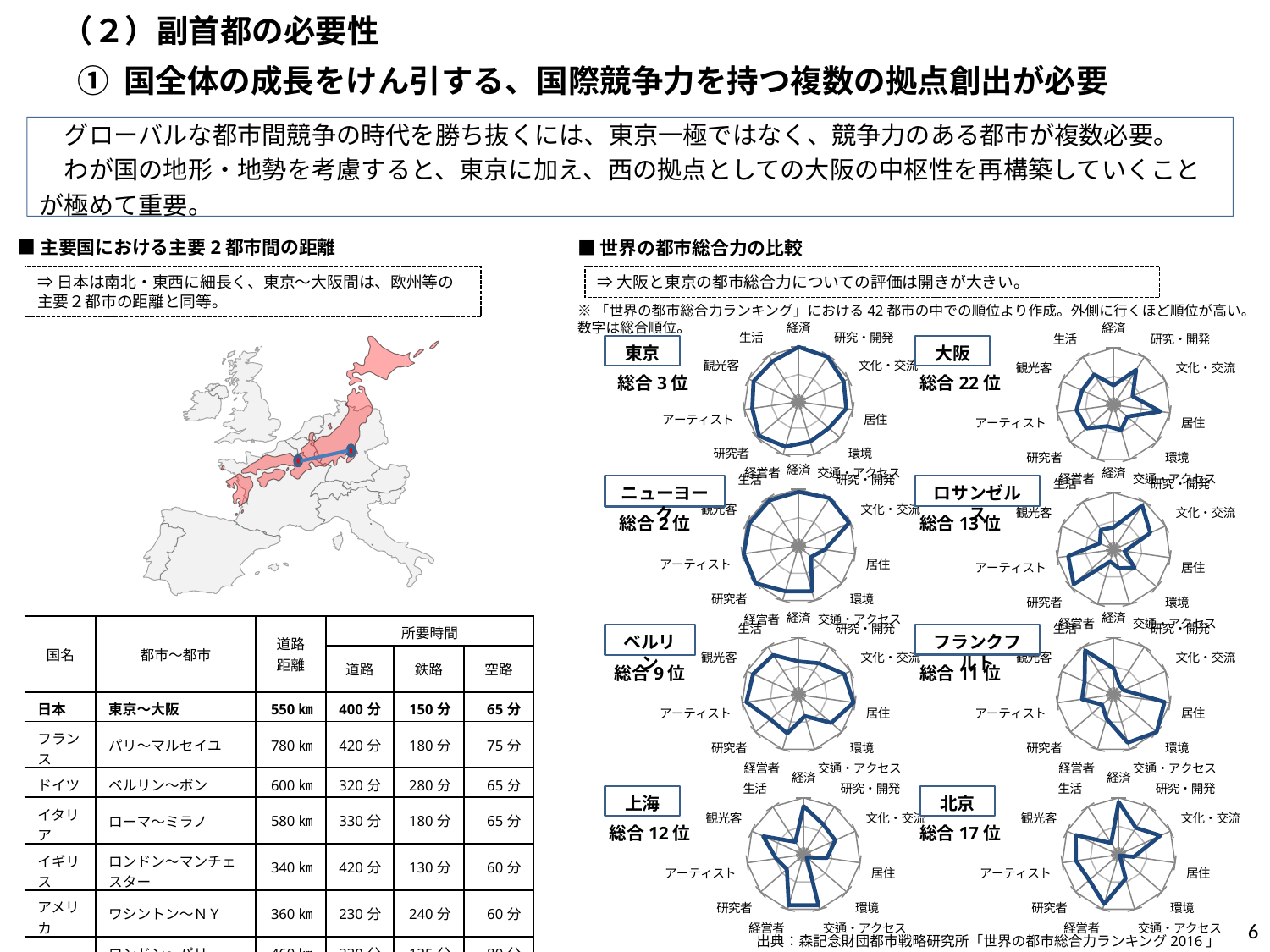
In the 世界の都市総合力の比較 section, what is the overall rank (総合) shown for 北京? 総合17位 In the 世界の都市総合力の比較 section, which of the eight cities has the best (highest) overall rank? ニューヨーク In the 世界の都市総合力の比較 section, how many rank positions separate 大阪 (総合22位) from 東京 (総合3位)? 19 How many radar charts are shown in the 世界の都市総合力の比較 section? 8 In the 世界の都市総合力の比較 section, which city ranks higher overall, 東京 or 大阪? 東京 What kind of chart is used in the 世界の都市総合力の比較 section to compare the cities? Radar chart In the 世界の都市総合力の比較 section, what is the overall rank (総合) shown for 東京? 総合3位 In the 世界の都市総合力の比較 section, what is the overall rank (総合) shown for 大阪? 総合22位 In the 世界の都市総合力の比較 section, which of the eight cities has the lowest overall rank? 大阪 How many evaluation axes (categories) does each radar chart in the 世界の都市総合力の比較 section have? 11 What source is cited for the radar charts in the 世界の都市総合力の比較 section? 森記念財団都市戦略研究所「世界の都市総合力ランキング 2016」 In the 世界の都市総合力の比較 section, what is the overall rank (総合) shown for ニューヨーク? 総合2位